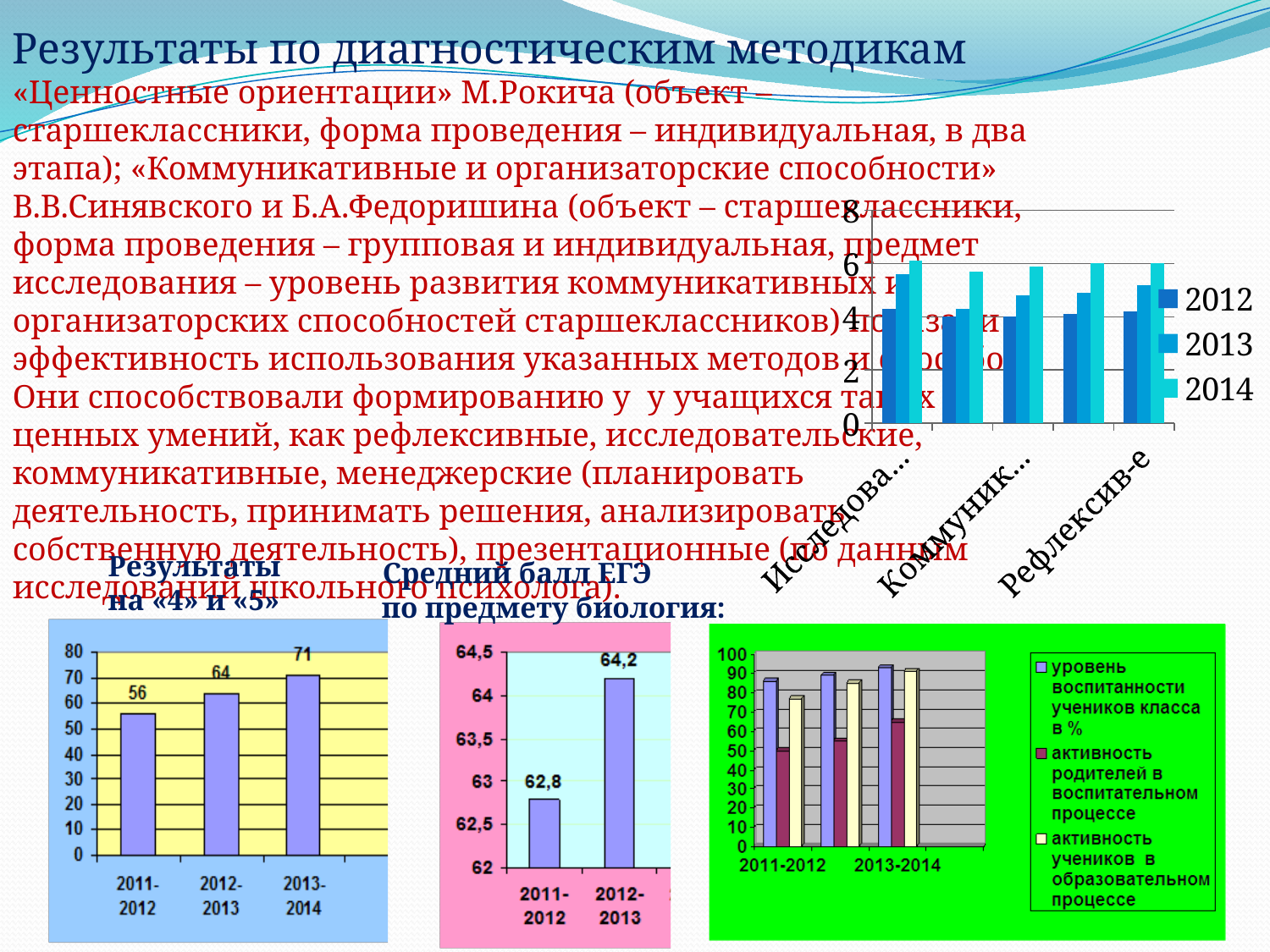
In the chart titled «Результаты на «4» и «5»», what is the value for 2013-2014? 71 In the chart at the top right of the slide, how many series does the legend list? 3 In the chart titled «Результаты на «4» и «5»», do the values rise or fall from 2011-2012 to 2013-2014? rise In the chart titled «Средний балл ЕГЭ по предмету биология», what is the value for 2012-2013? 64,2 In the green chart at the bottom right of the slide, is the value for «уровень воспитанности учеников класса в %» in 2011-2012 greater or less than 50? greater What kind of chart is the one titled «Результаты на «4» и «5»»? bar chart In the chart titled «Средний балл ЕГЭ по предмету биология», what is the difference between the values for 2012-2013 and 2011-2012? 1,4 In the chart titled «Результаты на «4» и «5»», which year has the highest value? 2013-2014 In the chart titled «Результаты на «4» и «5»», what is the difference between the values for 2013-2014 and 2011-2012? 15 In the chart titled «Результаты на «4» и «5»», how many categories are shown on the x axis? 3 In the chart titled «Средний балл ЕГЭ по предмету биология», which year has the larger value, 2011-2012 or 2012-2013? 2012-2013 In the chart titled «Результаты на «4» и «5»», what is the value for 2011-2012? 56